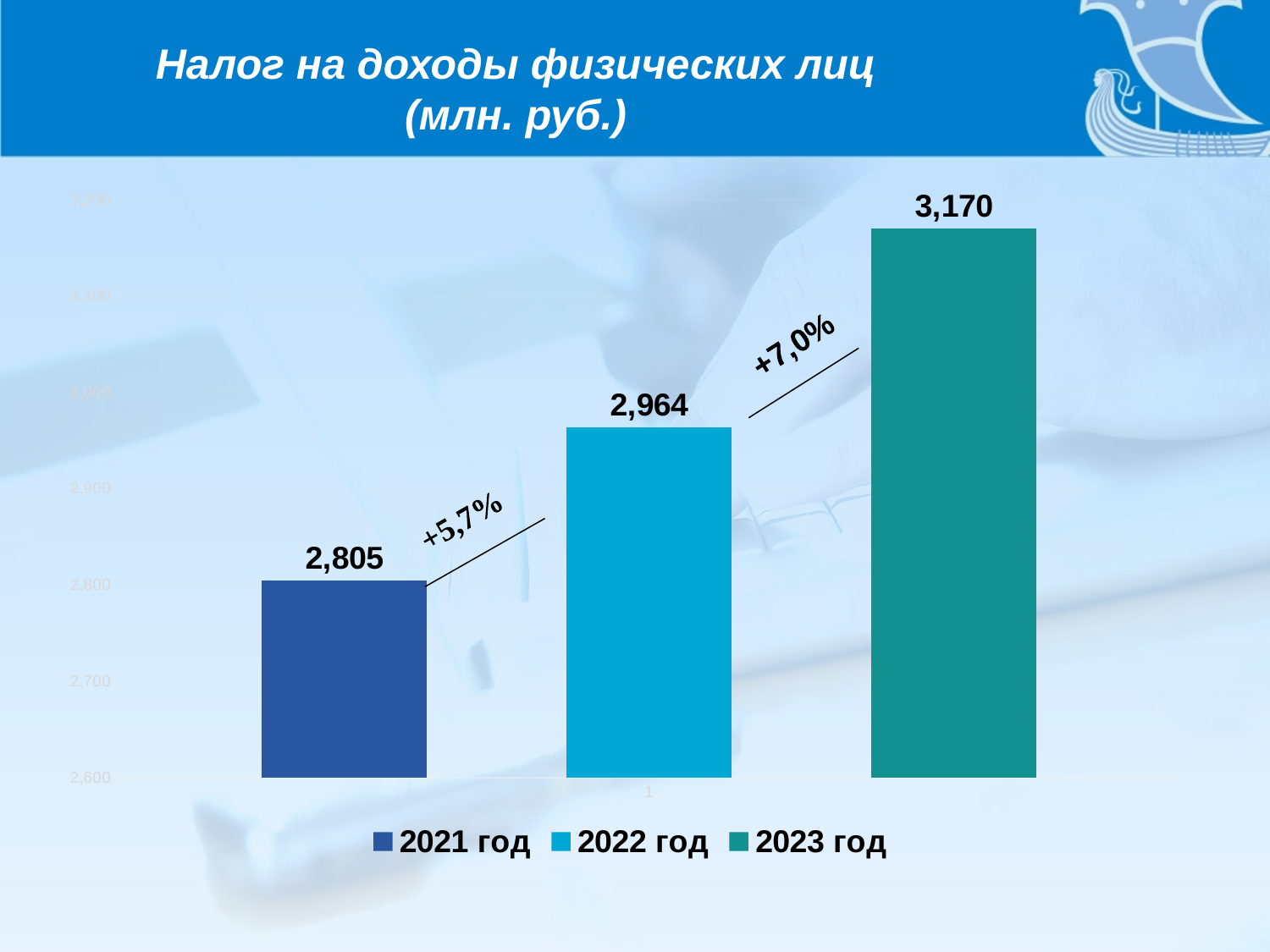
What is the value for 2023 год? 3,170 How many series does the legend list? 3 What is the value for 2021 год? 2,805 What percentage growth is shown between 2022 год and 2023 год? +7,0% What is the difference between the values for 2023 год and 2022 год? 206 Which is larger, the value for 2021 год or the value for 2022 год? 2022 год What is the value for 2022 год? 2,964 How many bars are plotted on the chart? 3 Which year has the highest value? 2023 год What is the difference between the values for 2022 год and 2021 год? 159 What kind of chart is shown on the slide? bar chart Which year has the lowest value? 2021 год